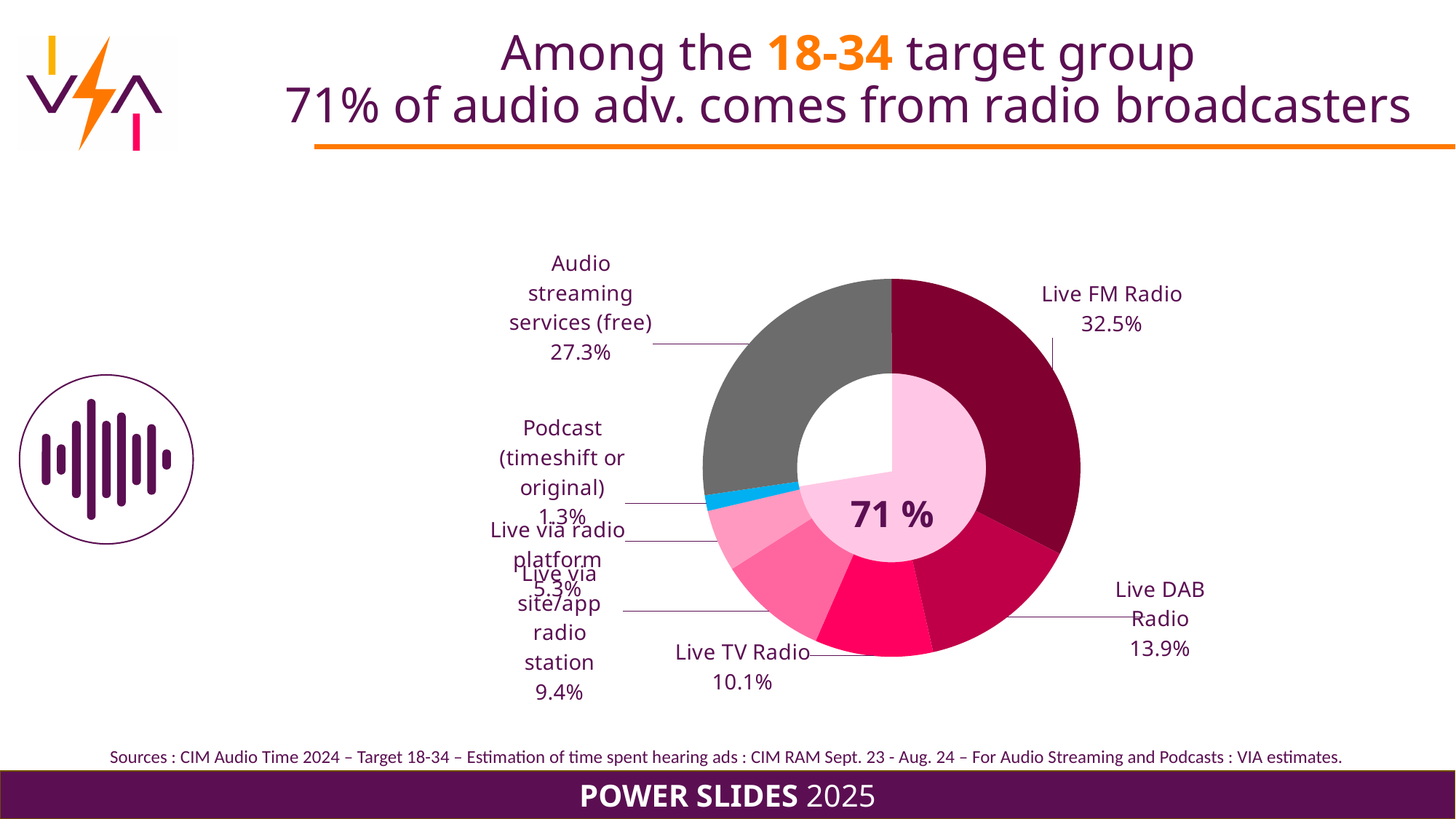
Which is larger, Live TV Radio or Live via site/app radio station? Live TV Radio How many categories are shown in the chart? 7 What share does Live DAB Radio have in the chart? 13.9% Which category has the smallest share in the chart? Podcast (timeshift or original) What share does Audio streaming services (free) have in the chart? 27.3% What percentage is printed in the centre of the doughnut chart? 71 % What is the combined share of Live via radio platform and Live via site/app radio station? 14.7% What share does Podcast (timeshift or original) have in the chart? 1.3% What kind of chart is shown on the slide? Doughnut chart Which category has the largest share in the chart? Live FM Radio What share does Live FM Radio have in the chart? 32.5% What is the difference in percentage points between Live FM Radio and Live DAB Radio? 18.6